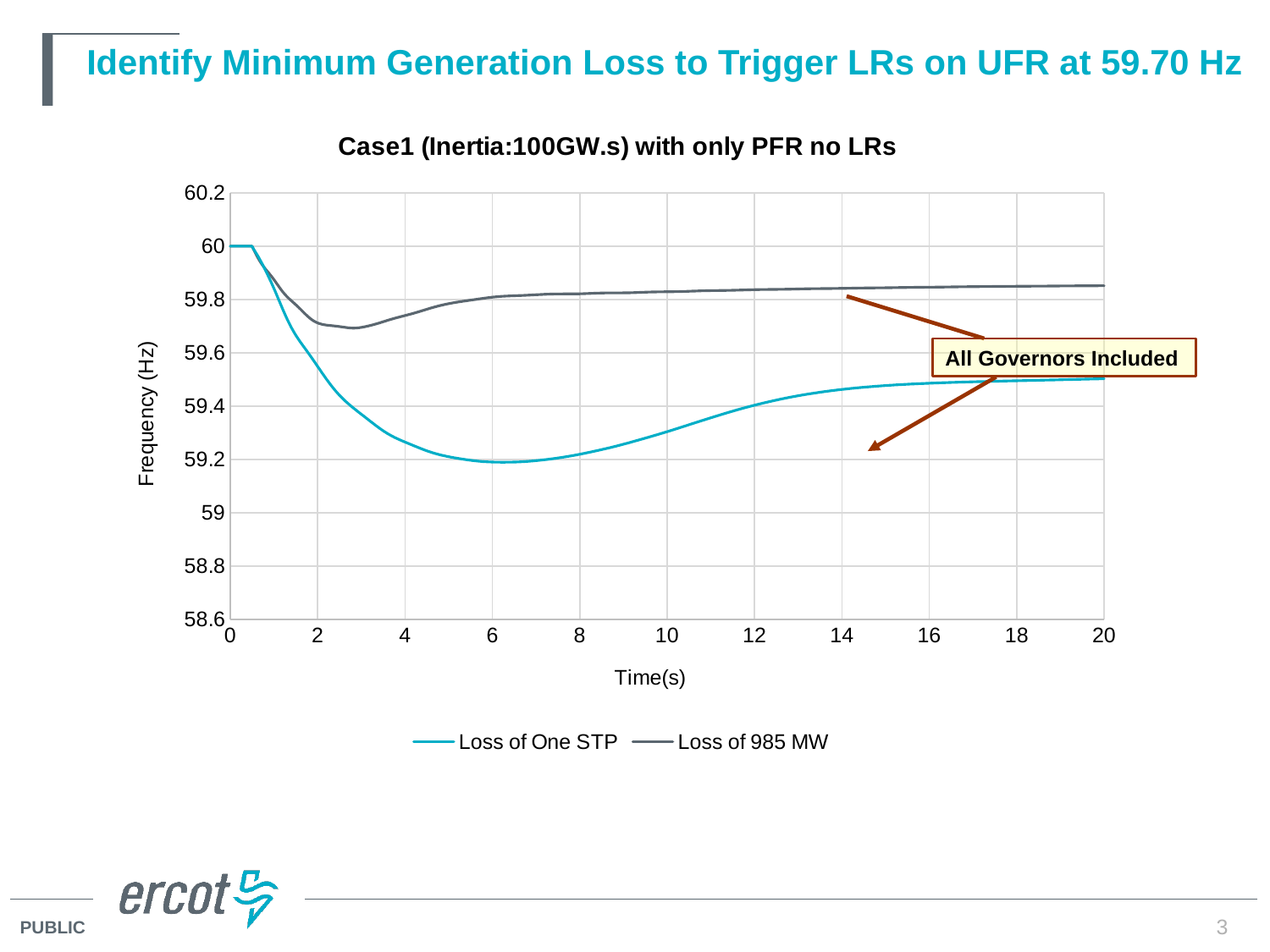
What is the title of the chart? Case1 (Inertia:100GW.s) with only PFR no LRs Is the value of the Loss of One STP series at time 20 greater or less than 59.4? greater What kind of chart is shown on the slide? line chart Does the Loss of One STP series rise or fall between time 8 and time 20? rise How many series does the legend list? 2 Is the minimum frequency reached by the Loss of One STP series greater or less than 59.4? less Is the value of the Loss of 985 MW series at time 20 greater or less than 59.8? greater What is the frequency value of both series at time 0? 60 Does the Loss of 985 MW series rise or fall between time 0 and time 2? fall What text is shown in the annotation box on the chart? All Governors Included Which series reaches the lower minimum frequency, Loss of One STP or Loss of 985 MW? Loss of One STP